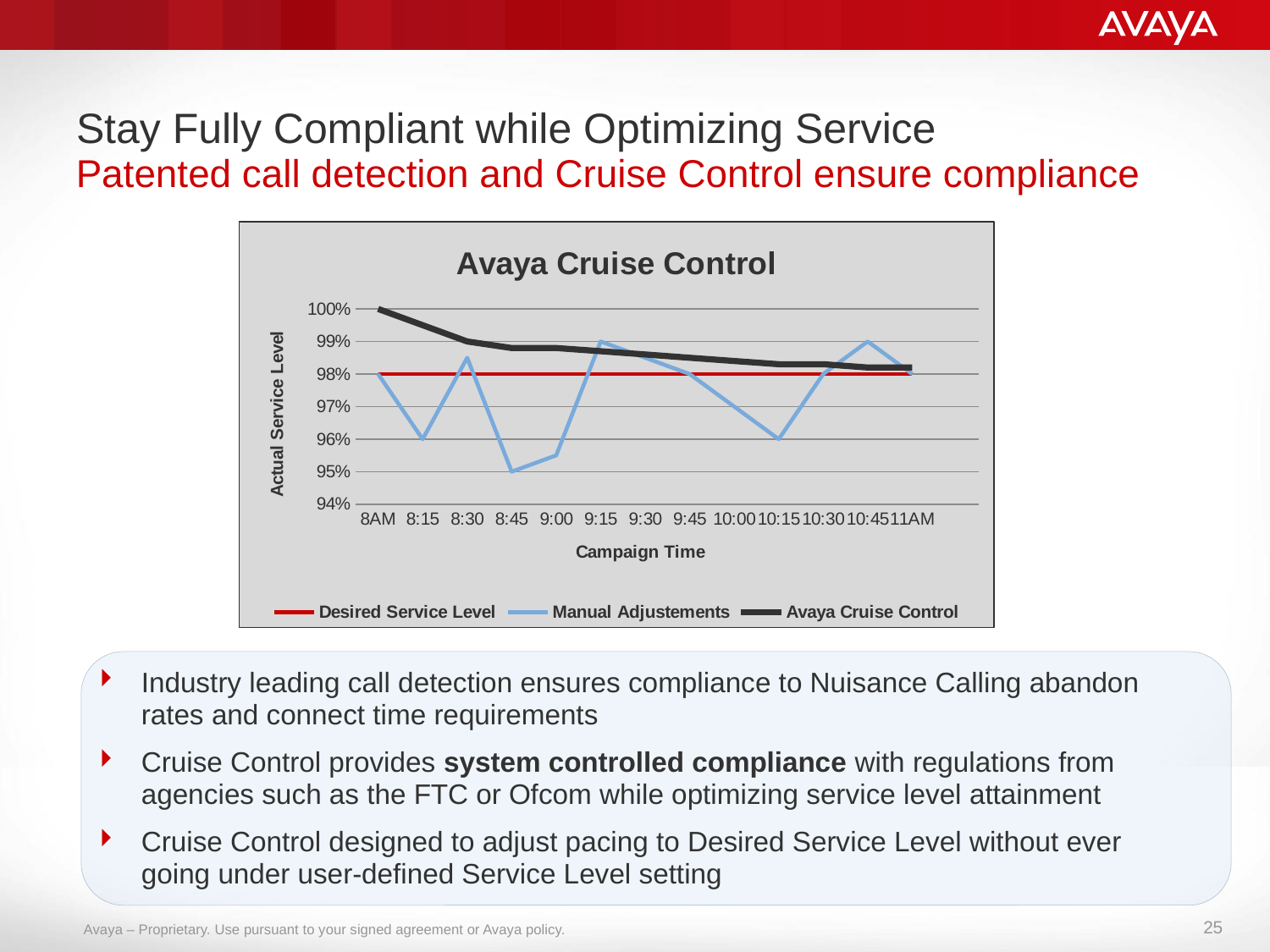
At 8:15, which series has the higher value, Avaya Cruise Control or Manual Adjustements? Avaya Cruise Control Is the Manual Adjustements value at 8:45 greater or less than 96%? less What is the Avaya Cruise Control value at 8AM? 100% How many series does the legend of the Avaya Cruise Control chart list? 3 How many campaign time points are shown along the x axis of the chart? 13 Does the Avaya Cruise Control line generally rise or fall from 8AM to 11AM? Fall What kind of chart is shown on the slide? Line chart Is the Avaya Cruise Control value at 9:00 greater or less than 98%? greater What value does the Desired Service Level line sit at throughout the chart? 98% What is the title of the x axis of the chart? Campaign Time What is the Manual Adjustements value at 8:15? 96% At which campaign time does the Manual Adjustements line reach its lowest point? 8:45